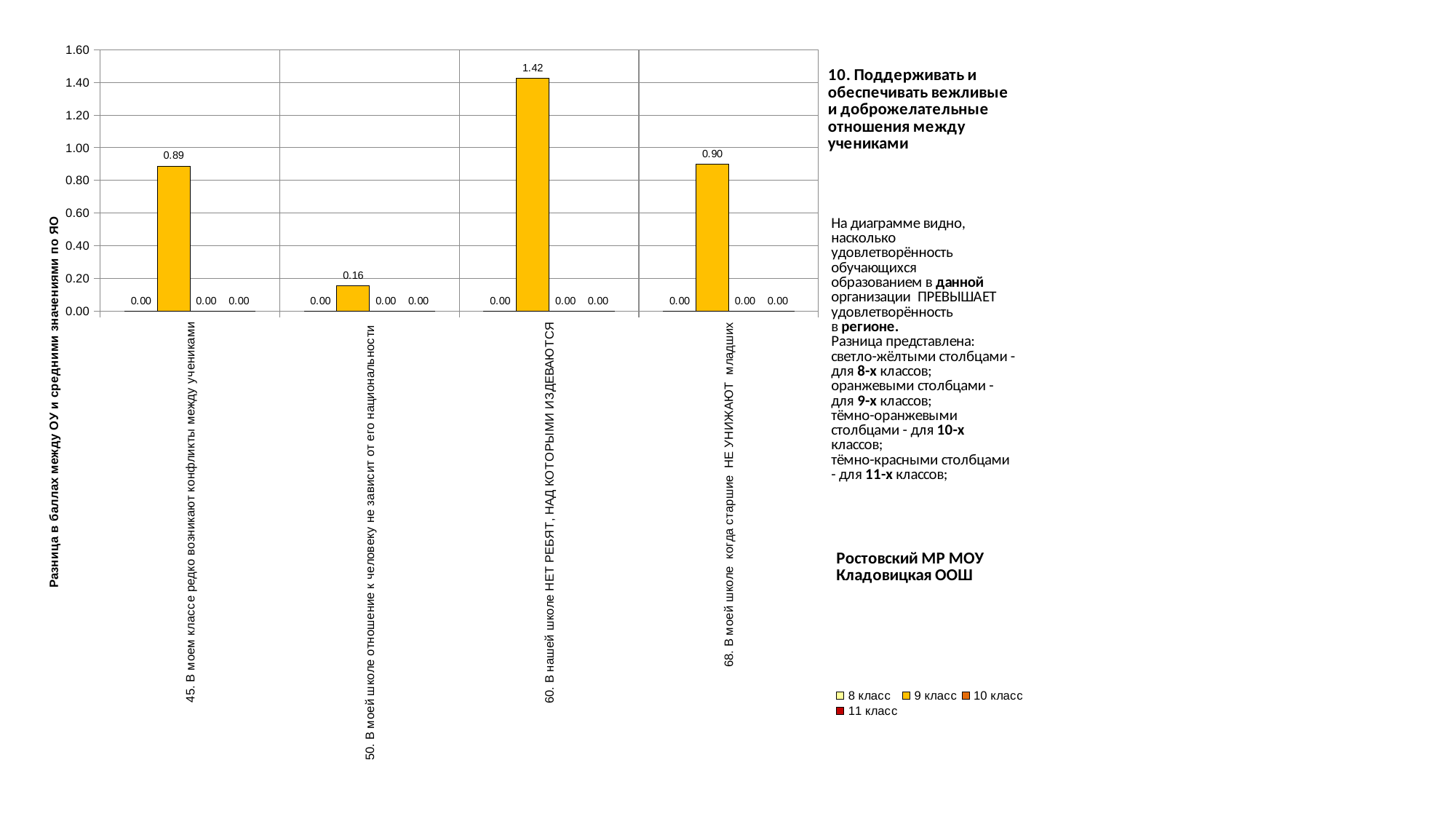
What is the value for "9 класс" in category "45. В моем классе редко возникают конфликты между учениками"? 0.89 What is the value for "9 класс" in category "50. В моей школе отношение к человеку не зависит от его национальности"? 0.16 Which is larger for "9 класс": the value for category 68 or the value for category 50? 68. В моей школе когда старшие НЕ УНИЖАЮТ младших How many categories are shown on the x axis? 4 How many series does the legend list? 4 Which category has the lowest value for "9 класс"? 50. В моей школе отношение к человеку не зависит от его национальности Is the "9 класс" value for category 60 greater or less than 1.00? greater What kind of chart is shown on the slide? bar chart What is the value for "9 класс" in category "60. В нашей школе НЕТ РЕБЯТ, НАД КОТОРЫМИ ИЗДЕВАЮТСЯ"? 1.42 What is the difference between the "9 класс" values for category 60 and category 45? 0.53 Which category has the highest value for "9 класс"? 60. В нашей школе НЕТ РЕБЯТ, НАД КОТОРЫМИ ИЗДЕВАЮТСЯ What is the value for "8 класс" in category "68. В моей школе когда старшие НЕ УНИЖАЮТ младших"? 0.00